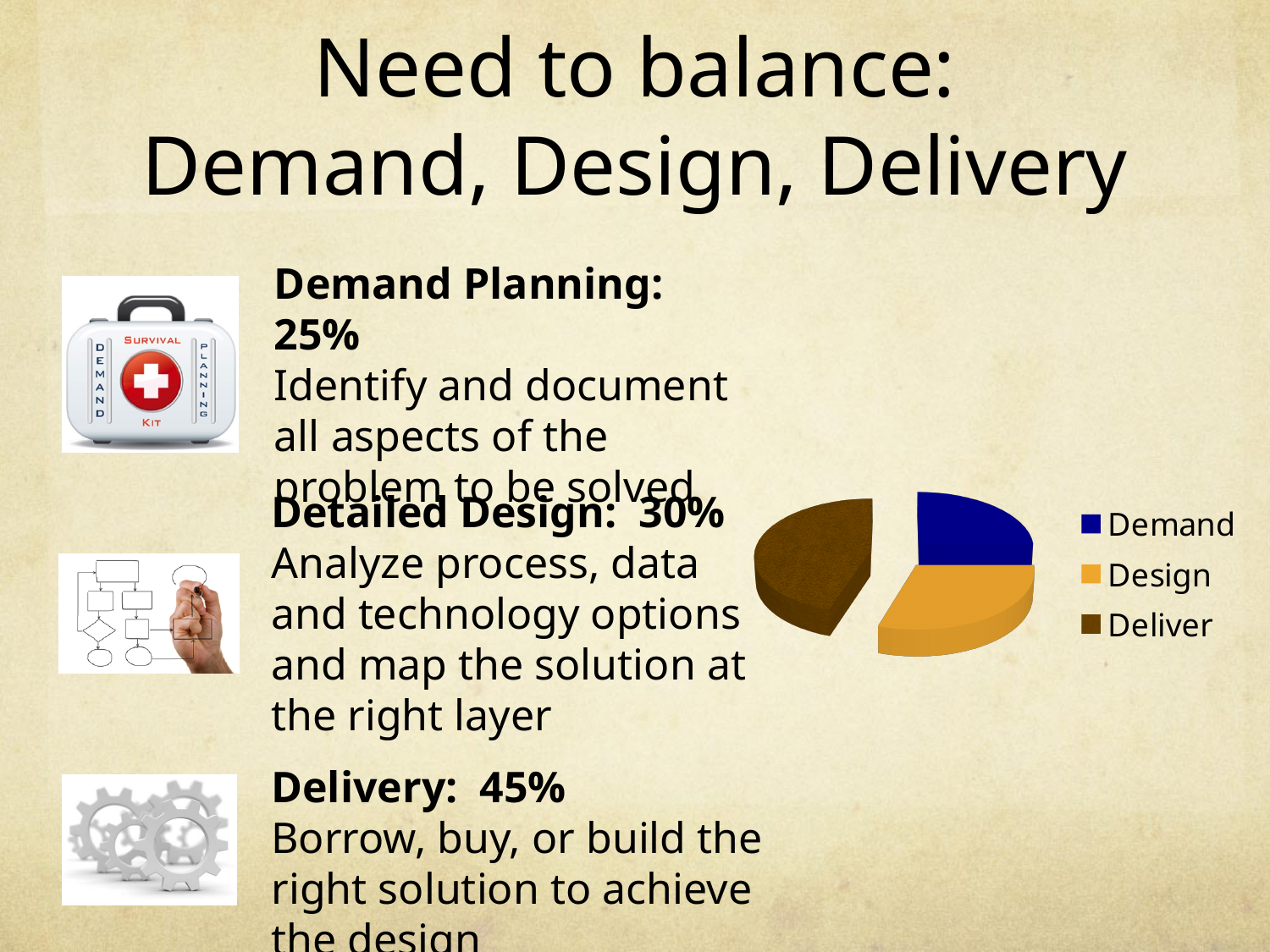
According to the slide, what share does Demand Planning represent in the pie chart? 25% According to the slide, what share does Delivery represent in the pie chart? 45% Which is larger in the pie chart, the Demand slice or the Deliver slice? Deliver Which is larger in the pie chart, the Deliver slice or the Design slice? Deliver What kind of chart is shown on the slide? pie chart Which slice of the pie chart is the largest? Deliver Which slice of the pie chart is the smallest? Demand Which legend entry in the pie chart is shown in brown? Deliver According to the slide, what share does Detailed Design represent in the pie chart? 30% How many entries does the pie chart's legend list? 3 What colour is the Demand slice in the pie chart? blue How many slices does the pie chart have? 3